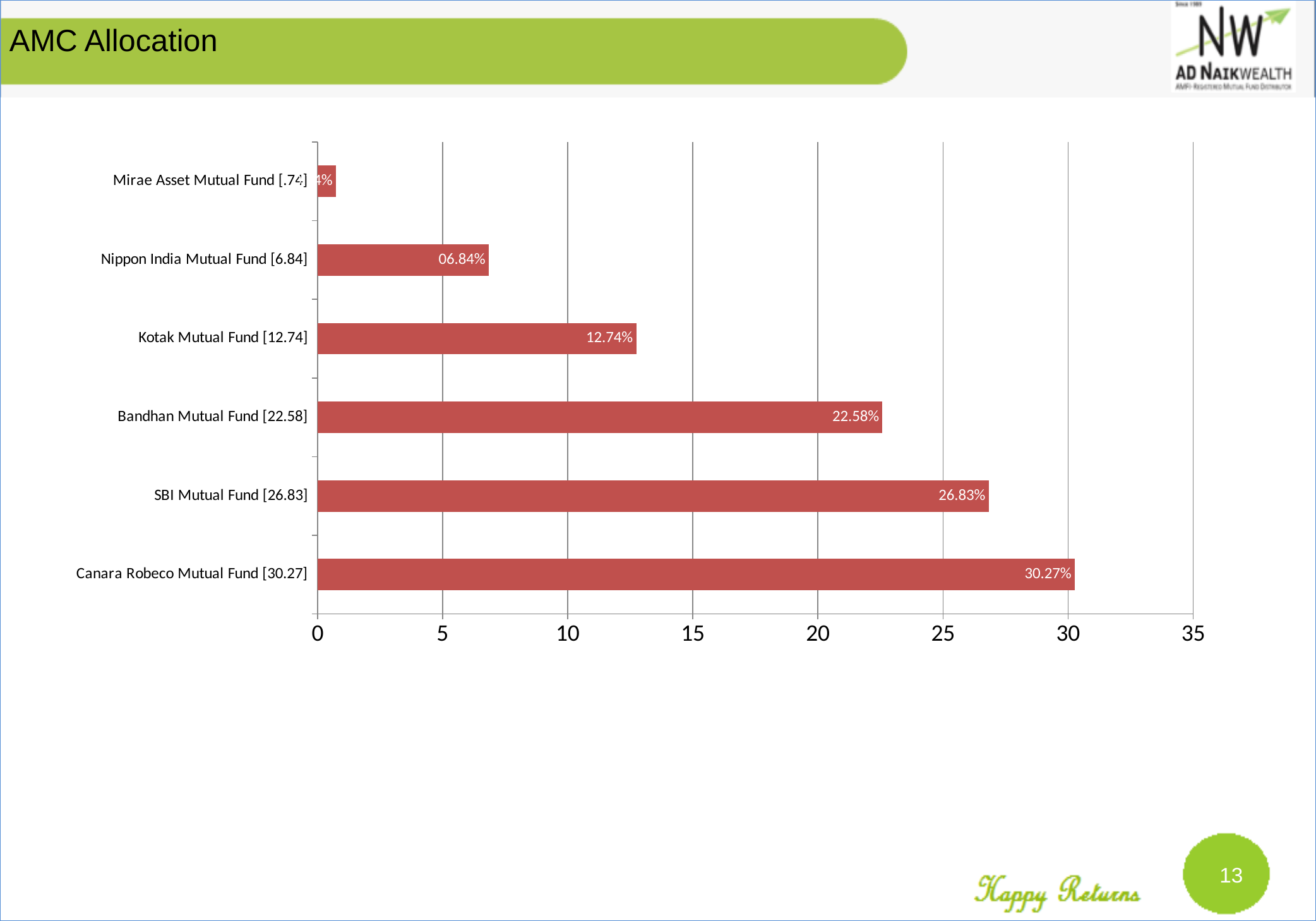
Which fund has the lowest allocation? Mirae Asset Mutual Fund What is the difference between the values for Canara Robeco Mutual Fund and SBI Mutual Fund? 3.44% What kind of chart is shown on the slide? Bar chart What is the data label shown on the bar for Nippon India Mutual Fund? 06.84% How many funds are shown in the chart? 6 What is the value shown for Bandhan Mutual Fund? 22.58% Which fund has the highest allocation? Canara Robeco Mutual Fund What is the value shown for Kotak Mutual Fund? 12.74% What is the difference between the values for Bandhan Mutual Fund and Kotak Mutual Fund? 9.84% Which is larger, the value for SBI Mutual Fund or the value for Bandhan Mutual Fund? SBI Mutual Fund What is the value shown for Canara Robeco Mutual Fund? 30.27% What is the value shown for SBI Mutual Fund? 26.83%